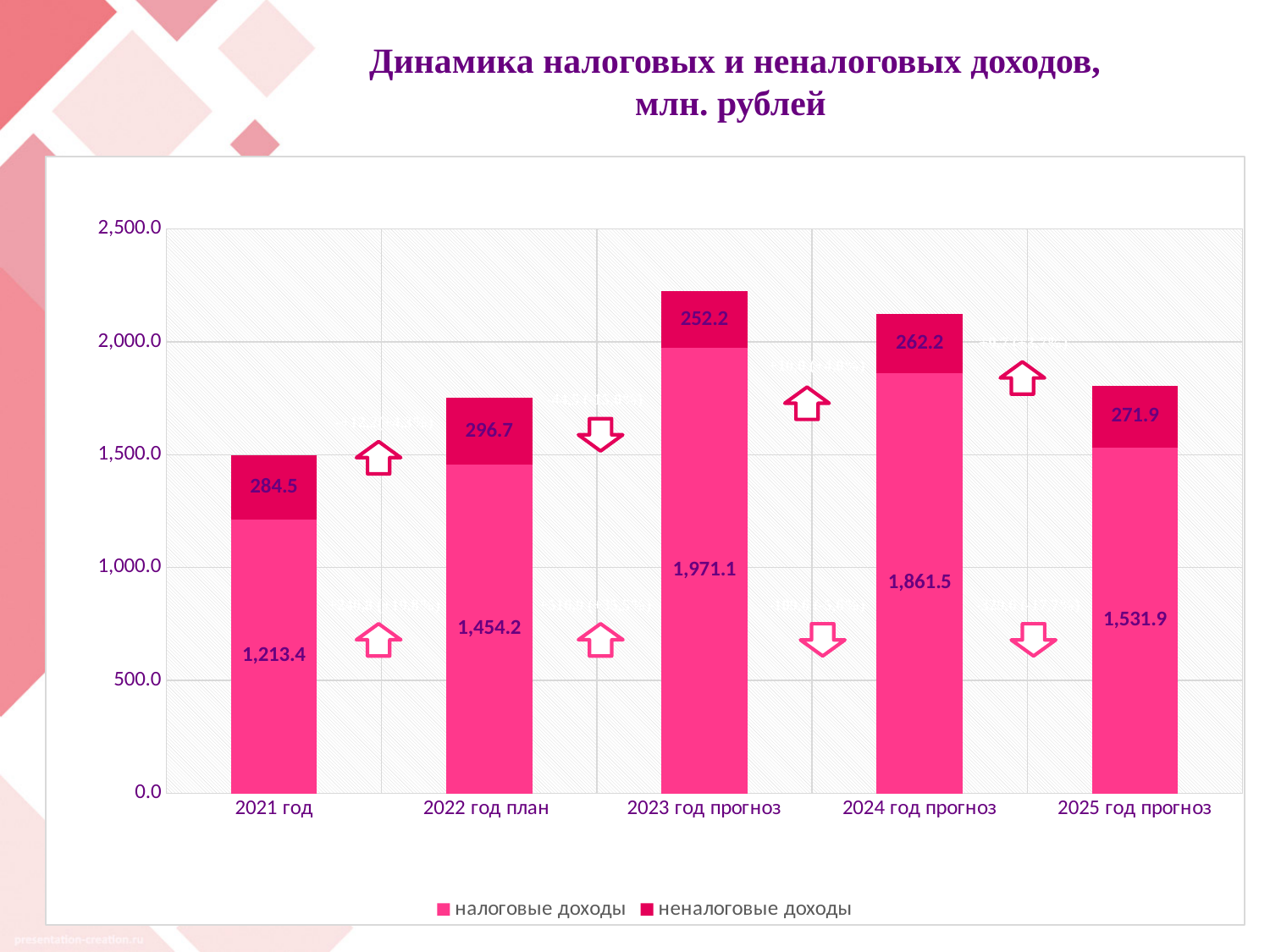
Which year has the highest value of налоговые доходы? 2023 год прогноз Is the total height of the 2023 год прогноз bar greater or less than 2,000.0? greater What kind of chart is shown on the slide? stacked bar chart How many years (categories) are shown on the x axis? 5 Which year has the lowest value of неналоговые доходы? 2023 год прогноз What is the total of the stacked bar for 2021 год? 1,497.9 What is the value of неналоговые доходы for 2021 год? 284.5 What is the value of налоговые доходы for 2023 год прогноз? 1,971.1 What is the difference between налоговые доходы in 2024 год прогноз and 2025 год прогноз? 329.6 What is the value of налоговые доходы for 2025 год прогноз? 1,531.9 How many series does the legend list? 2 Which is larger: неналоговые доходы in 2022 год план or in 2024 год прогноз? 2022 год план